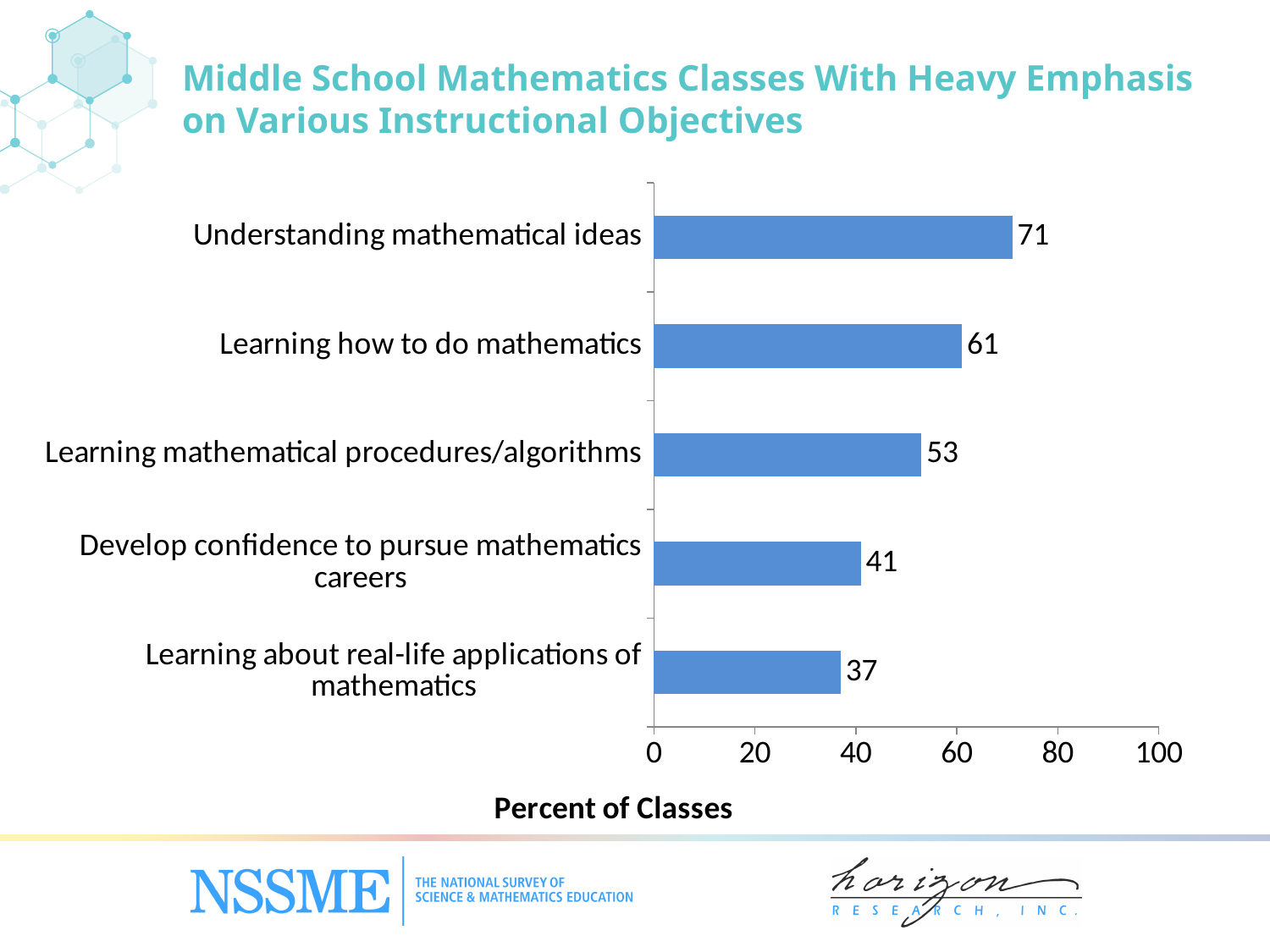
Which instructional objective has the highest percent of classes? Understanding mathematical ideas What is the value for learning mathematical procedures/algorithms? 53 What is the value for learning about real-life applications of mathematics? 37 What is the value for develop confidence to pursue mathematics careers? 41 How many instructional objectives are shown in the chart? 5 Which is larger: the value for learning mathematical procedures/algorithms or the value for develop confidence to pursue mathematics careers? Learning mathematical procedures/algorithms What is the label of the horizontal axis? Percent of Classes What is the value for learning how to do mathematics? 61 What kind of chart is shown on the slide? Bar chart What percent of classes place heavy emphasis on understanding mathematical ideas? 71 Which instructional objective has the lowest percent of classes? Learning about real-life applications of mathematics What is the difference between the values for understanding mathematical ideas and learning how to do mathematics? 10